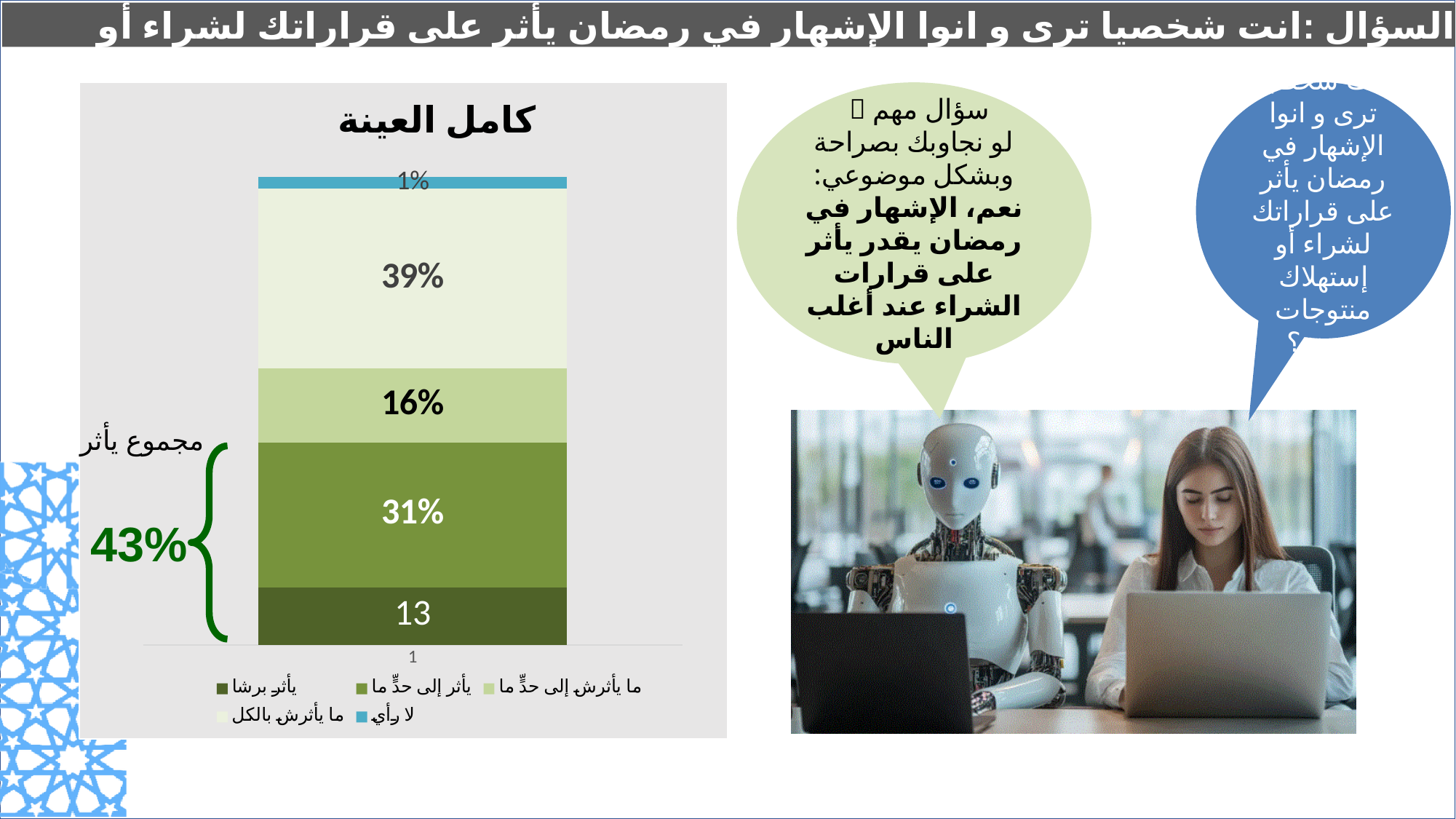
Which segment of the stacked bar has the smallest value? لا رأي What is the value shown for the segment "ما يأثرش إلى حدٍّ ما"? 16% What is the title of the chart? كامل العينة What is the value shown for the segment "يأثر إلى حدٍّ ما"? 31% What is the value shown for the segment "لا رأي"? 1% What kind of chart is shown on the slide? Stacked bar chart Which segment of the stacked bar has the largest value? ما يأثرش بالكل What is the difference between the values for "ما يأثرش بالكل" and "ما يأثرش إلى حدٍّ ما"? 23% How many series does the chart legend list? 5 What is the value shown for the segment "ما يأثرش بالكل"? 39% Which is larger, the value for "يأثر إلى حدٍّ ما" or the value for "ما يأثرش إلى حدٍّ ما"? يأثر إلى حدٍّ ما What is the value shown for the segment "يأثر برشا"? 13